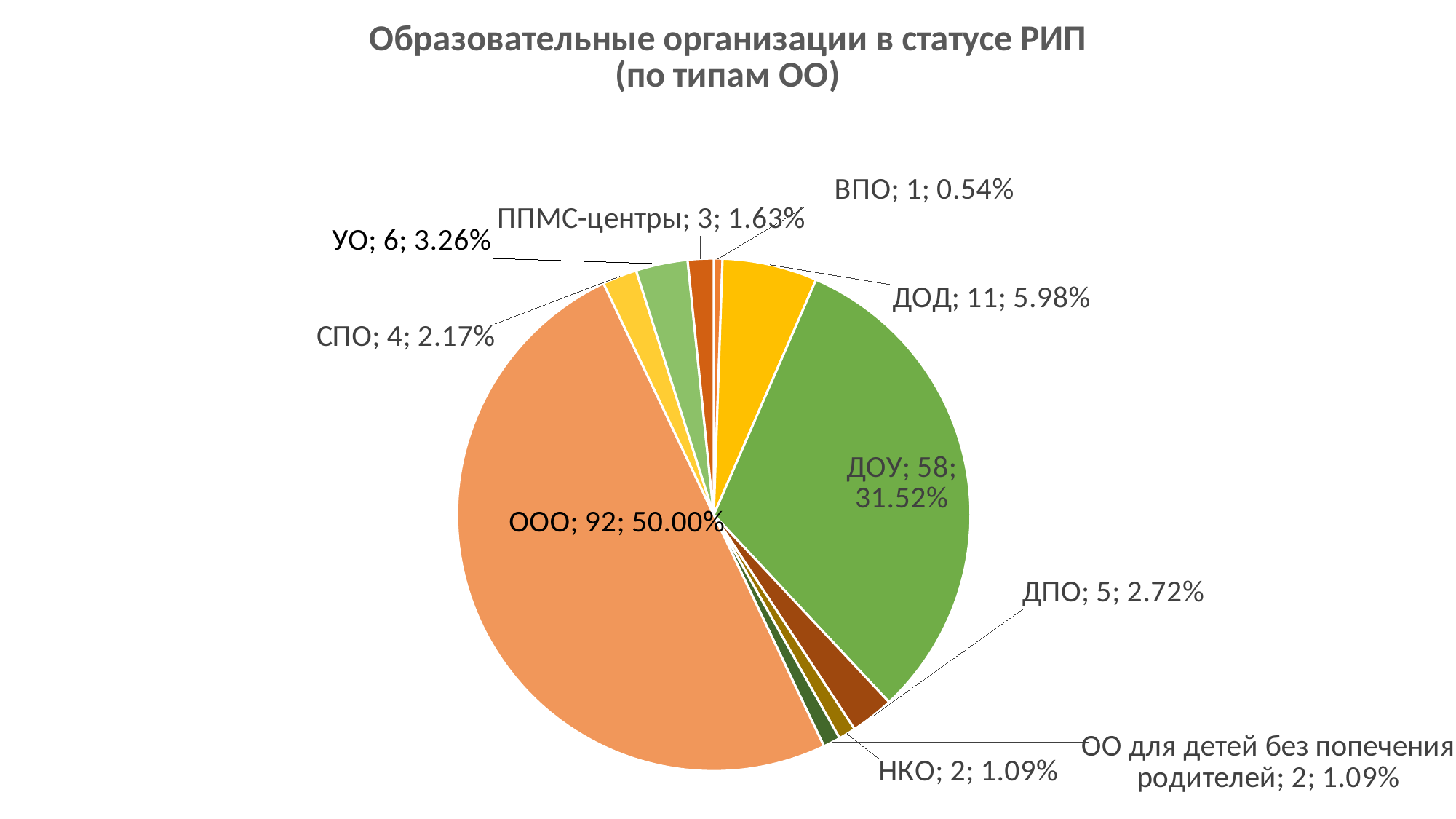
What share of the pie does ООО represent? 50.00% What is the title of the chart? Образовательные организации в статусе РИП (по типам ОО) What is the value for ДОУ? 58 Which category has the smallest slice? ВПО Which is larger, the value for УО or the value for СПО? УО What is the difference between the values for ООО and ДОУ? 34 What is the value for ДПО? 5 What kind of chart is shown on the slide? pie chart What is the value for ДОД? 11 How many categories (slices) does the pie chart have? 10 What share of the pie does ППМС-центры represent? 1.63% Which category has the largest slice? ООО